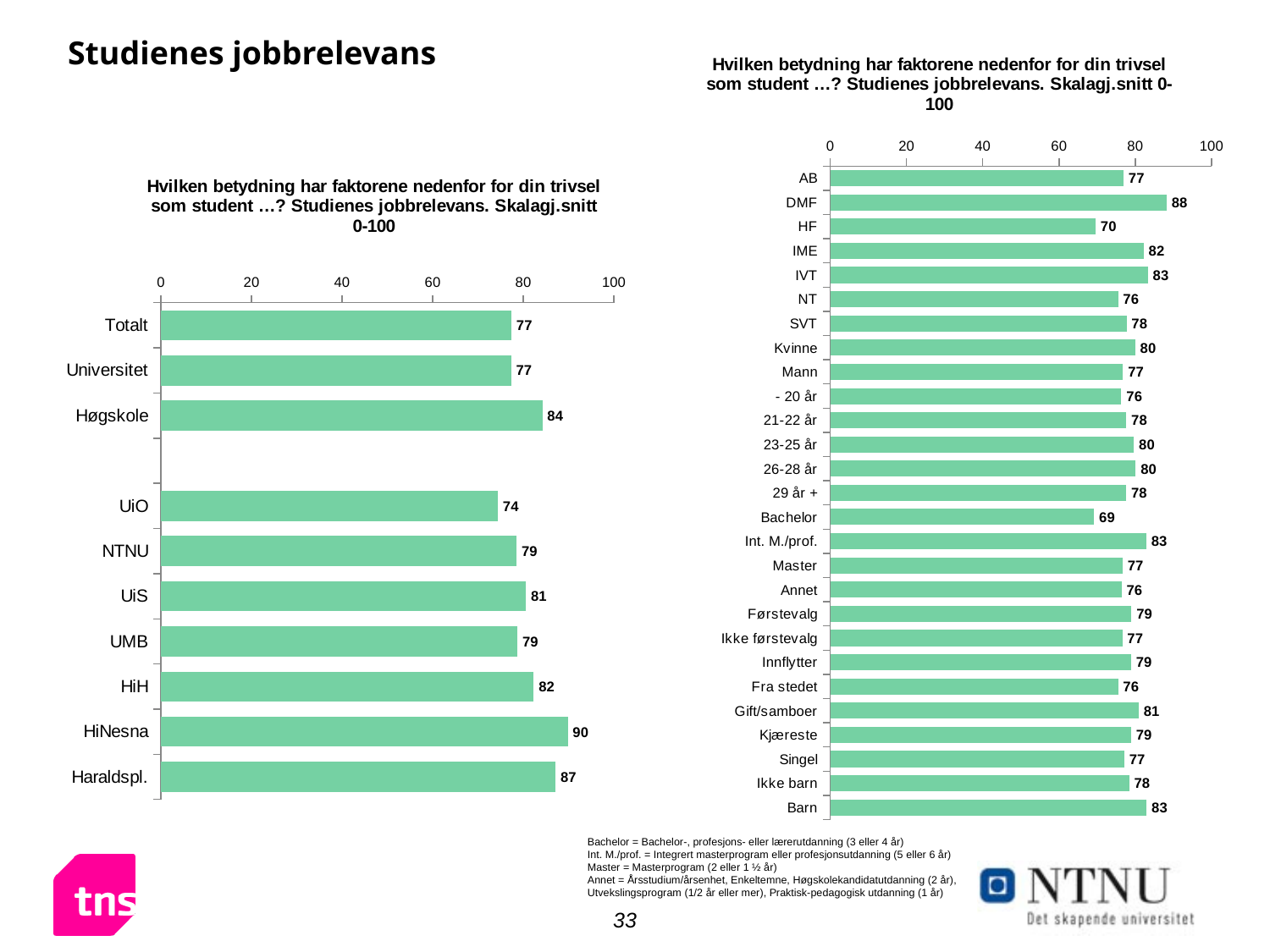
On the left chart, which category has the highest value? HiNesna What kind of chart is the left chart? Bar chart On the left chart, what is the value for HiNesna? 90 On the left chart, which is larger, the value for Høgskole or the value for Universitet? Høgskole On the right chart, what is the value for Bachelor? 69 On the right chart, which category has the lowest value? Bachelor On the left chart, what is the difference between the values for Haraldspl. and Totalt? 10 On the right chart, how many categories are plotted? 27 On the left chart, how many categories are plotted? 10 On the left chart, which category has the lowest value? UiO On the right chart, what is the difference between the values for DMF and HF? 18 On the right chart, which category has the highest value? DMF